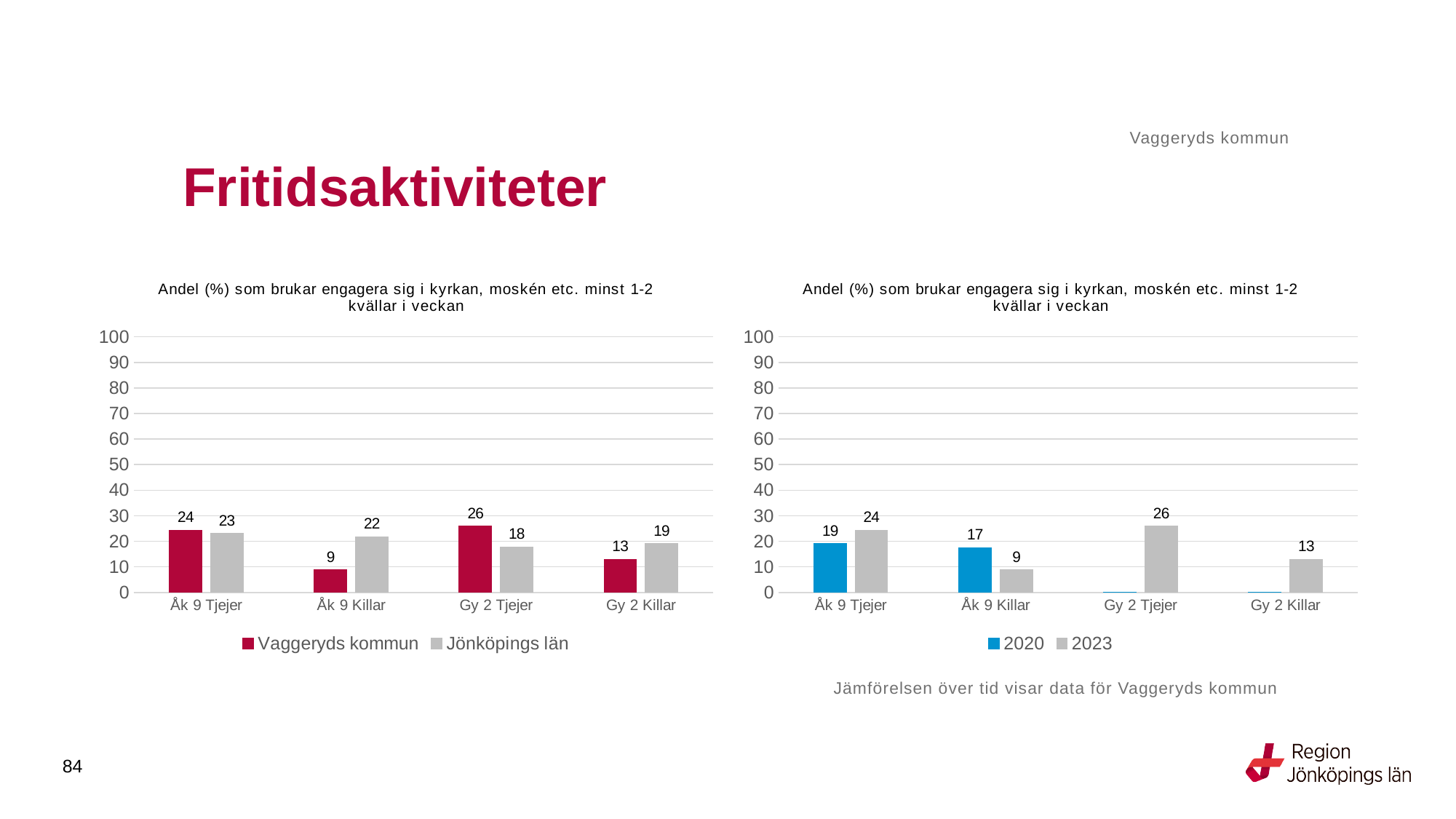
In the right chart, what is the value for 2023 for Gy 2 Tjejer? 26 What kind of chart is the left chart? Bar chart In the left chart, what is the difference between Jönköpings län and Vaggeryds kommun for Åk 9 Killar? 13 How many series does the legend of the right chart list? 2 In the right chart, what is the difference between 2023 and 2020 for Åk 9 Tjejer? 5 In the right chart, which category has the lowest value for 2023? Åk 9 Killar In the right chart, what is the value for 2020 for Åk 9 Killar? 17 In the left chart, which category has the highest value for Vaggeryds kommun? Gy 2 Tjejer In the left chart, which is larger for Gy 2 Tjejer: Vaggeryds kommun or Jönköpings län? Vaggeryds kommun In the left chart, what is the value for Vaggeryds kommun for Åk 9 Tjejer? 24 In the left chart, what is the value for Jönköpings län for Åk 9 Killar? 22 In the left chart, which category has the lowest value for Vaggeryds kommun? Åk 9 Killar